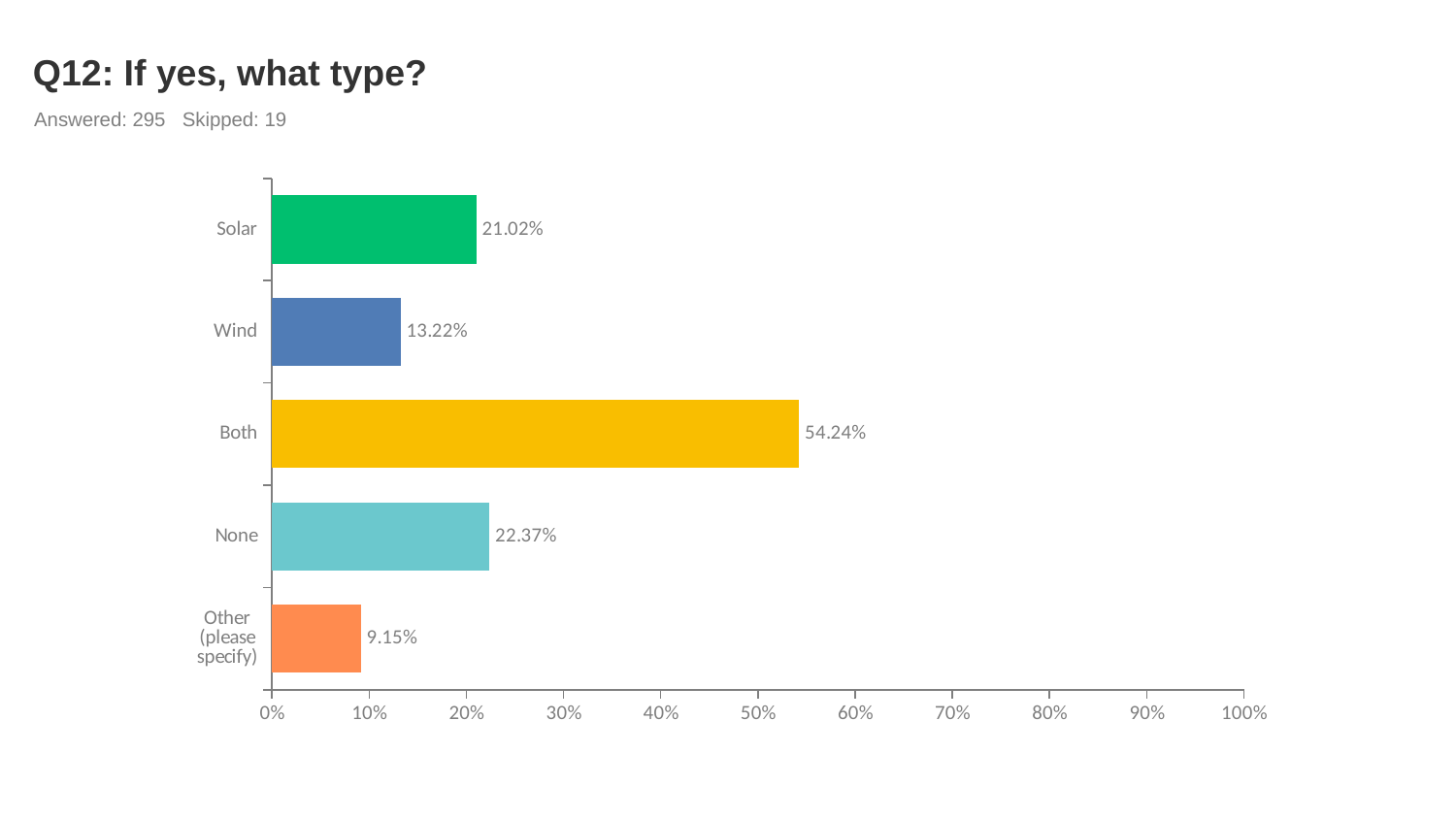
Which category has the lowest percentage? Other (please specify) What is the difference between the percentages for Both and None? 31.87% What is the title of the chart? Q12: If yes, what type? What percentage of respondents chose Solar? 21.02% What percentage is shown for Other (please specify)? 9.15% Which is larger, the value for Solar or the value for Wind? Solar What kind of chart is shown on the slide? bar chart Which category has the highest percentage? Both Is the value for Both greater or less than 50%? greater How many respondents answered the question according to the slide? 295 How many categories are shown in the chart? 5 What is the value shown for Wind? 13.22%